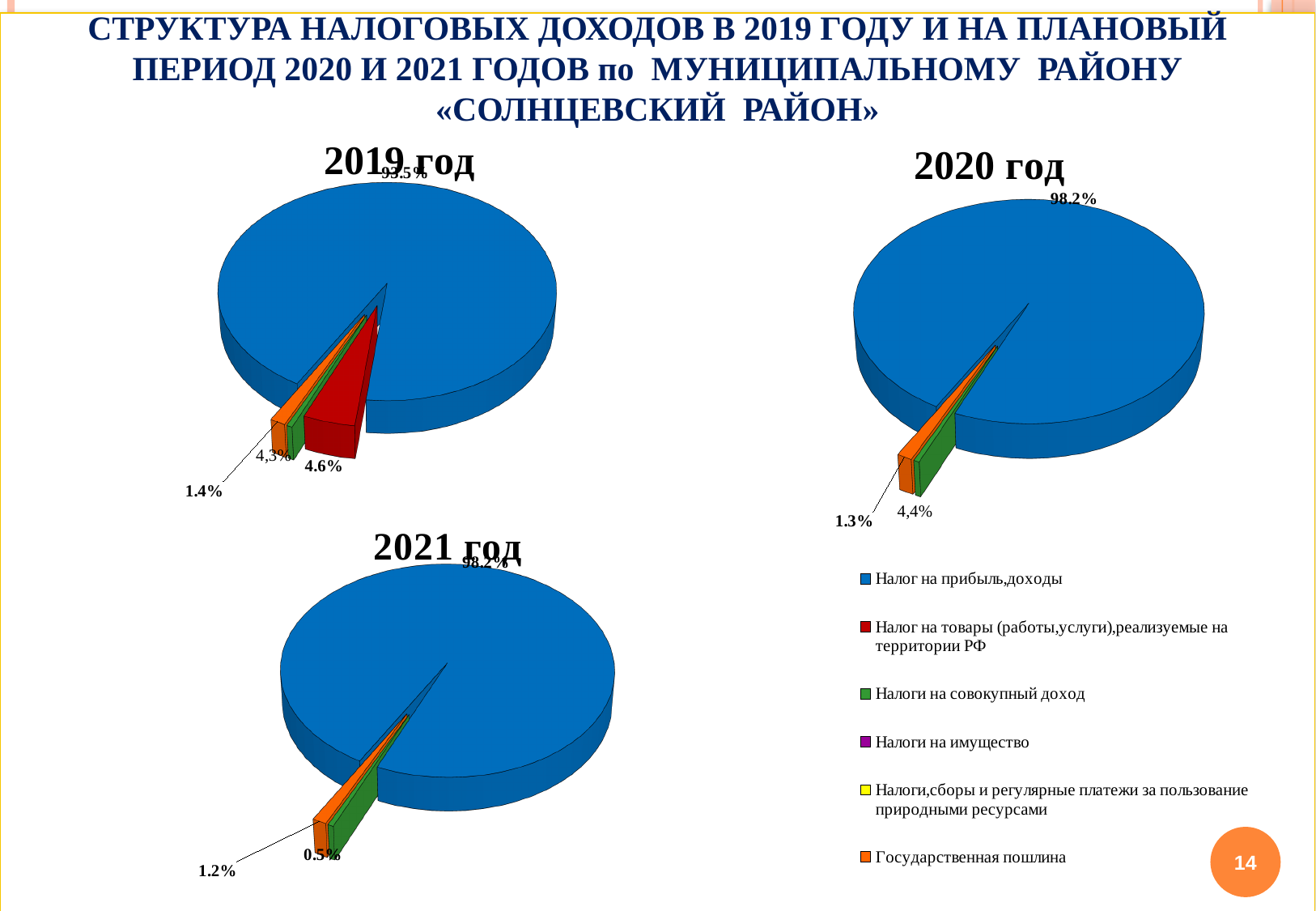
How many entries does the legend list? 6 In the 2021 год chart, which is larger: Государственная пошлина or Налоги на совокупный доход? Государственная пошлина In the 2020 год chart, what is the value for Государственная пошлина? 1.3% In the 2020 год chart, what is the value for Налог на прибыль,доходы? 98.2% In the 2021 год chart, what is the value for Налоги на совокупный доход? 0.5% In the 2019 год chart, what is the value for Государственная пошлина? 1.4% What kind of chart is used for the 2019 год chart? pie chart In the 2020 год chart, which category has the largest slice? Налог на прибыль,доходы In the 2019 год chart, what is the value for Налог на товары (работы,услуги),реализуемые на территории РФ? 4.6% In the 2021 год chart, what is the value for Государственная пошлина? 1.2% In the 2021 год chart, what is the difference between Государственная пошлина and Налоги на совокупный доход? 0.7%